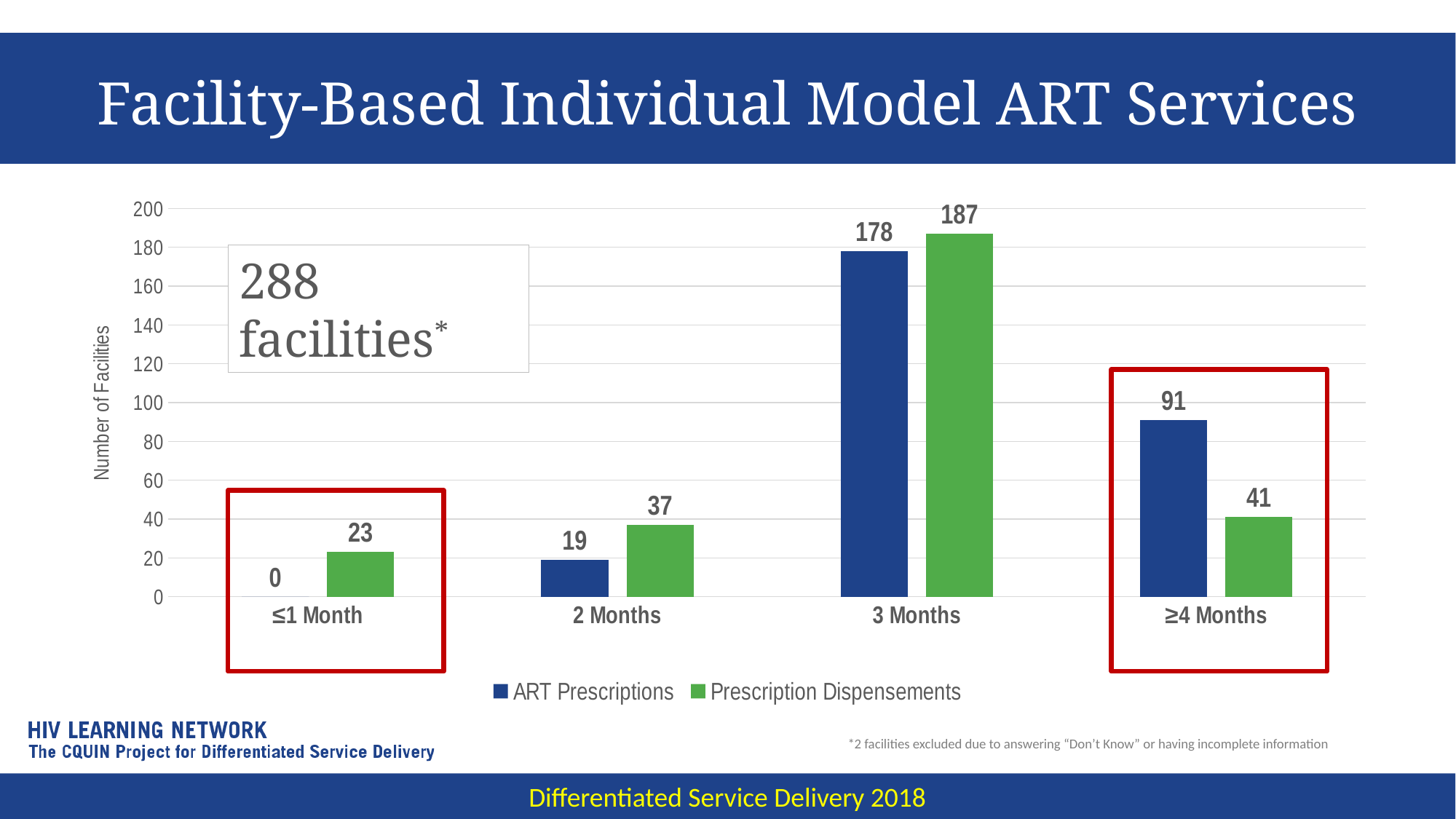
What is the label of the y axis? Number of Facilities Which category has the lowest value for ART Prescriptions? ≤1 Month What is the value for ART Prescriptions at 3 Months? 178 What kind of chart is shown on the slide? Bar chart What is the value for ART Prescriptions at ≤1 Month? 0 How many series does the legend list? 2 What is the difference between ART Prescriptions and Prescription Dispensements at ≥4 Months? 50 Which category has the highest value for Prescription Dispensements? 3 Months What is the value for Prescription Dispensements at ≥4 Months? 41 At 3 Months, which series has the larger value, ART Prescriptions or Prescription Dispensements? Prescription Dispensements What is the difference between Prescription Dispensements and ART Prescriptions at 2 Months? 18 How many categories are shown on the x axis? 4